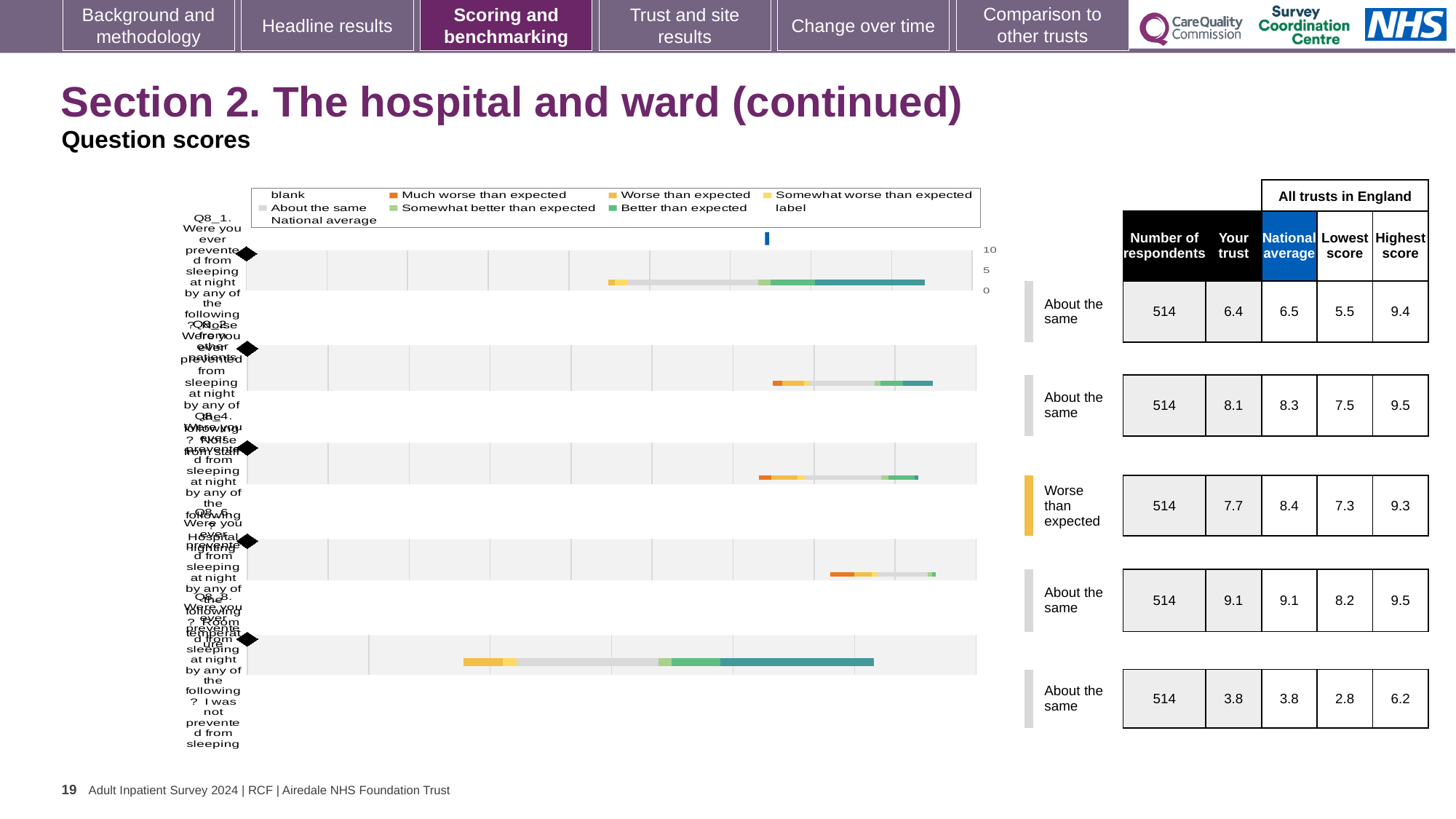
How many question rows (bars) are plotted in the chart? 5 Which rating is given to the third question row (Q8_4) in the chart? Worse than expected What is the highest tick value shown on the chart's axis? 10 In the table beside the chart, what is the 'Your trust' score for the row rated 'Worse than expected'? 7.7 In the table beside the chart, which row has the lowest 'Your trust' score? the last row (3.8) In the table beside the chart, is the trust score for the second row (8.1) larger or smaller than the national average (8.3)? smaller What kind of chart is shown on the slide? bar chart In the table beside the chart, what is the number of respondents for the first row? 514 In the table beside the chart, which row has the highest 'Your trust' score? the fourth row (9.1) In the table beside the chart, what is the difference between the national average (8.4) and the trust score (7.7) for the third row? 0.7 How many of the five question rows are rated 'About the same'? 4 Which legend entry is shown in orange? Much worse than expected